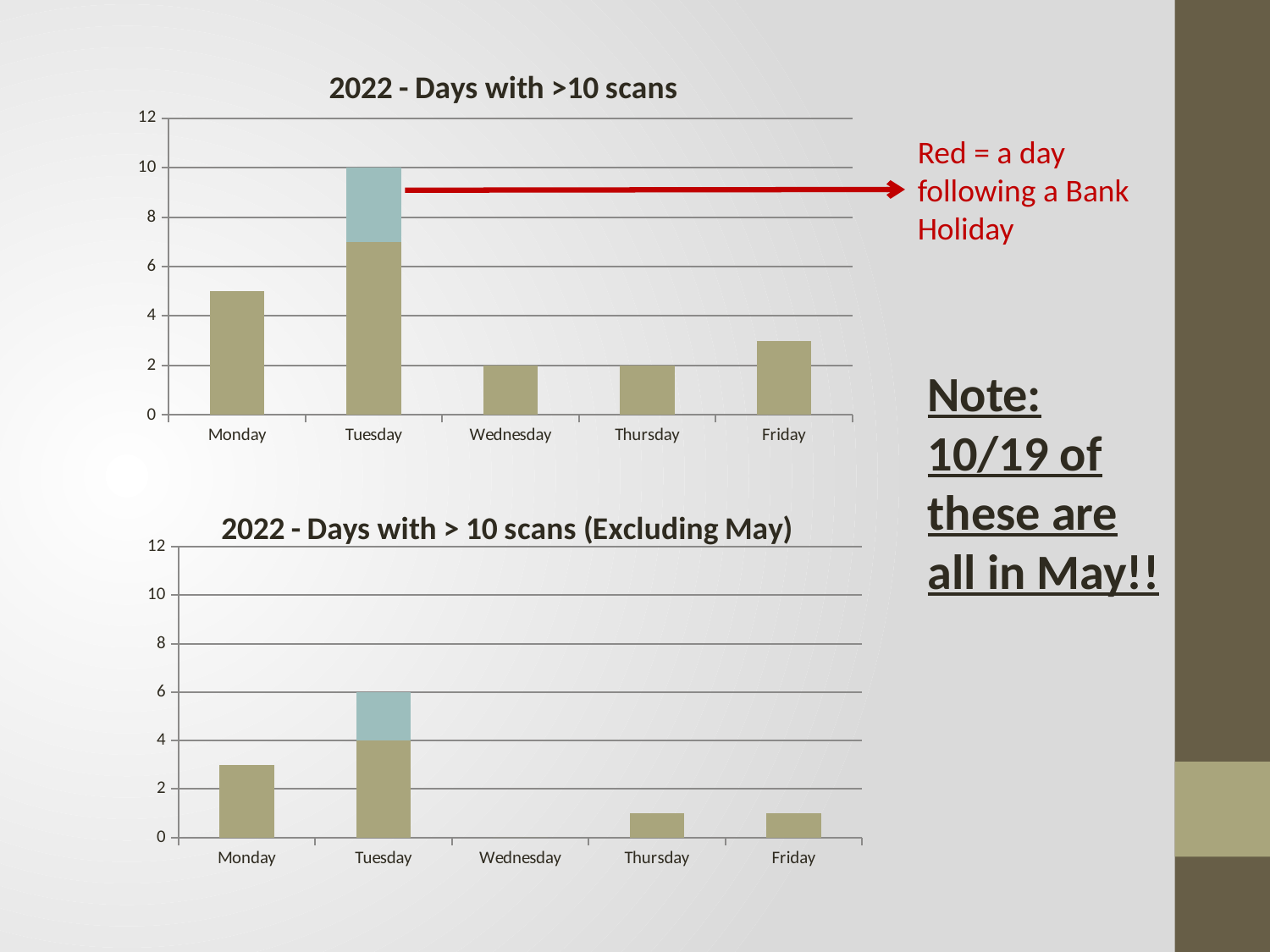
In the top chart, '2022 - Days with >10 scans', what is the total height of the Tuesday bar? 10 In the top chart, '2022 - Days with >10 scans', what is the difference between the total Tuesday bar and the Thursday bar? 8 In the top chart, '2022 - Days with >10 scans', is the value for Friday greater or less than 4? less In the bottom chart, '2022 - Days with > 10 scans (Excluding May)', is the value for Monday greater or less than 2? greater How many days are shown on the x axis of the bottom chart, '2022 - Days with > 10 scans (Excluding May)'? 5 In the top chart, '2022 - Days with >10 scans', which is larger, the bar for Monday or the bar for Friday? Monday What kind of chart is the top chart, '2022 - Days with >10 scans'? bar chart In the top chart, '2022 - Days with >10 scans', what is the value for Wednesday? 2 In the top chart, '2022 - Days with >10 scans', which day has the highest bar? Tuesday In the top chart, '2022 - Days with >10 scans', is the value for Monday greater or less than 4? greater In the bottom chart, '2022 - Days with > 10 scans (Excluding May)', which day has the lowest value? Wednesday In the bottom chart, '2022 - Days with > 10 scans (Excluding May)', what is the total height of the Tuesday bar? 6